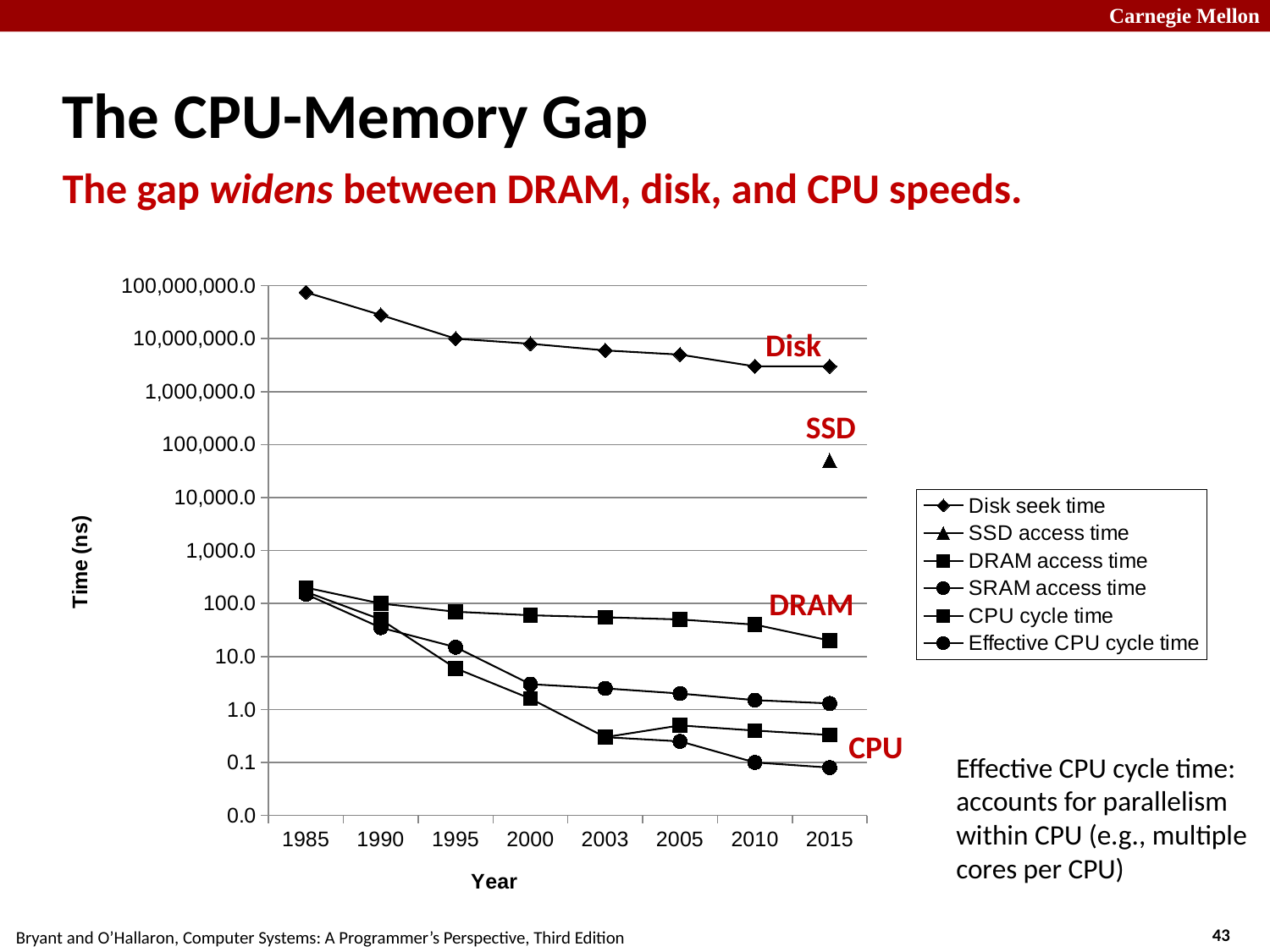
Does the Disk seek time rise or fall from 1985 to 2015? fall Is the Disk seek time in 1985 greater or less than 10,000,000.0? greater Is the CPU cycle time in 2015 greater or less than 1.0? less Is the SSD access time in 2015 greater or less than 100,000.0? less Which series has the lowest value in 2015? Effective CPU cycle time How many years are shown on the x axis? 8 Which series has the highest value in 2015? Disk seek time How many series does the legend list? 6 What kind of chart is shown on the slide? line chart In 2015, which is larger: DRAM access time or SRAM access time? DRAM access time What is the label of the y axis? Time (ns)